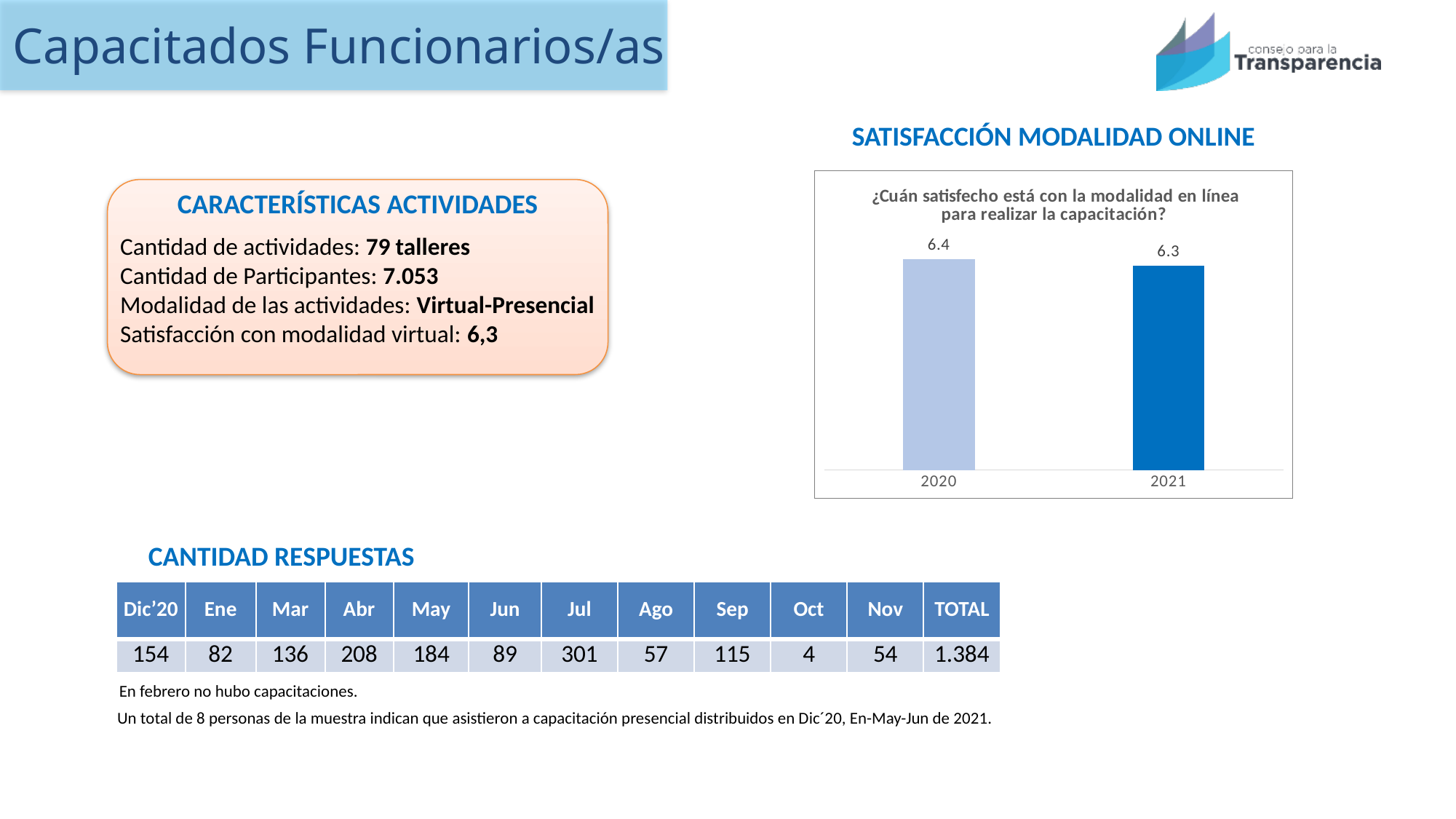
Which year has the lowest value in the chart? 2021 What kind of chart is shown on the slide? Bar chart Which is larger in the chart, the value for 2020 or the value for 2021? 2020 Do the values in the chart rise or fall from 2020 to 2021? Fall What is the difference between the values for 2020 and 2021 in the chart? 0.1 What heading appears above the chart on the slide? SATISFACCIÓN MODALIDAD ONLINE How many bars are shown in the chart? 2 What is the value for 2021 in the chart? 6.3 What is the value for 2020 in the chart? 6.4 What is the title of the chart? ¿Cuán satisfecho está con la modalidad en línea para realizar la capacitación? Which year has the highest value in the chart? 2020